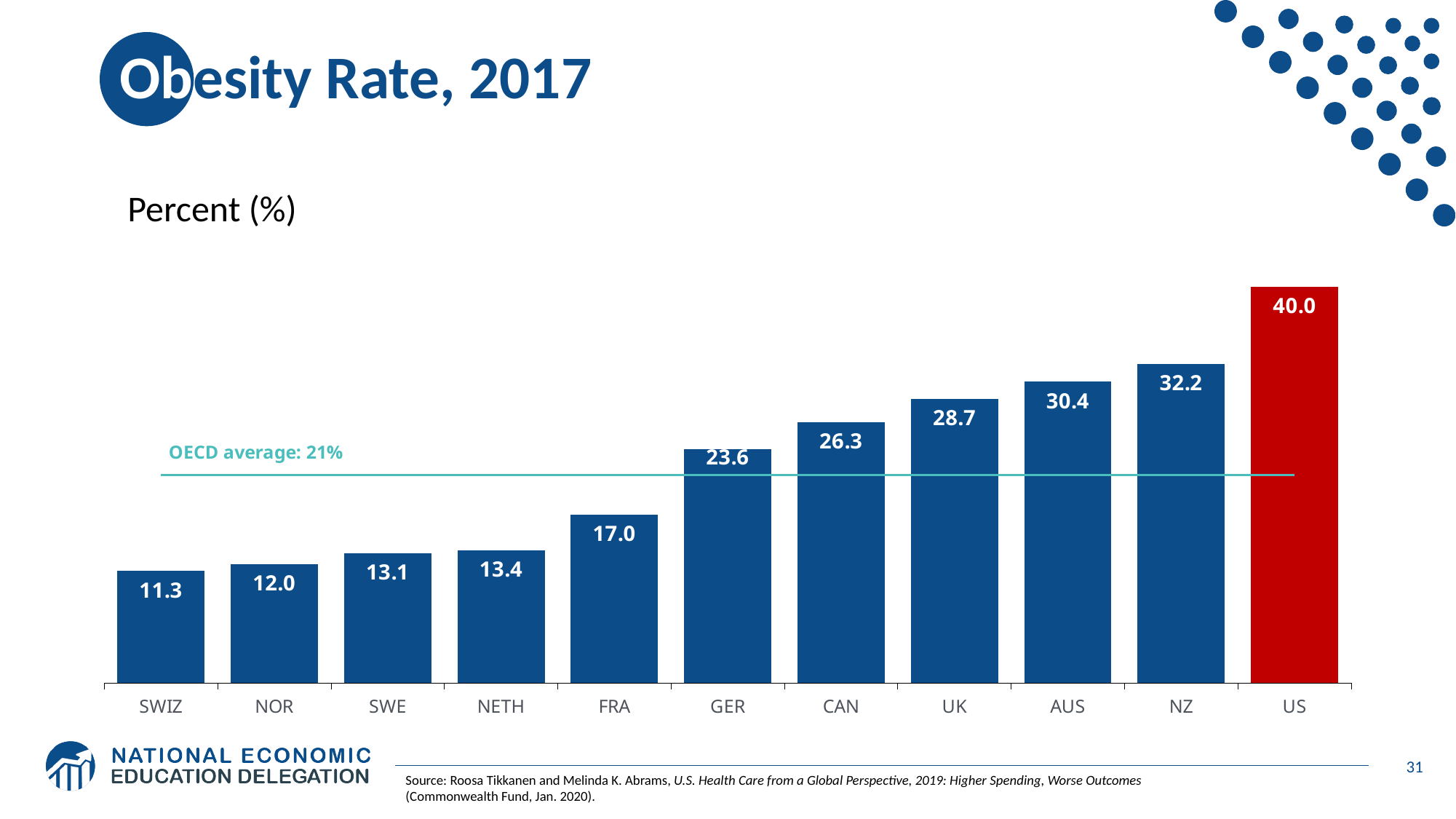
What is the difference between the obesity rates of the US and NZ? 7.8 What is the obesity rate shown for the US? 40.0 What is the obesity rate shown for NETH? 13.4 Which has a higher obesity rate, UK or AUS? AUS How many countries are shown on the chart? 11 Do the obesity rates rise or fall moving from left to right across the chart? Rise Which country has the lowest obesity rate on the chart? SWIZ What kind of chart is shown on the slide? Bar chart What OECD average value is marked by the horizontal line on the chart? 21% Which country has the highest obesity rate on the chart? US What is the obesity rate shown for GER? 23.6 What is the difference between the obesity rates of CAN and FRA? 9.3